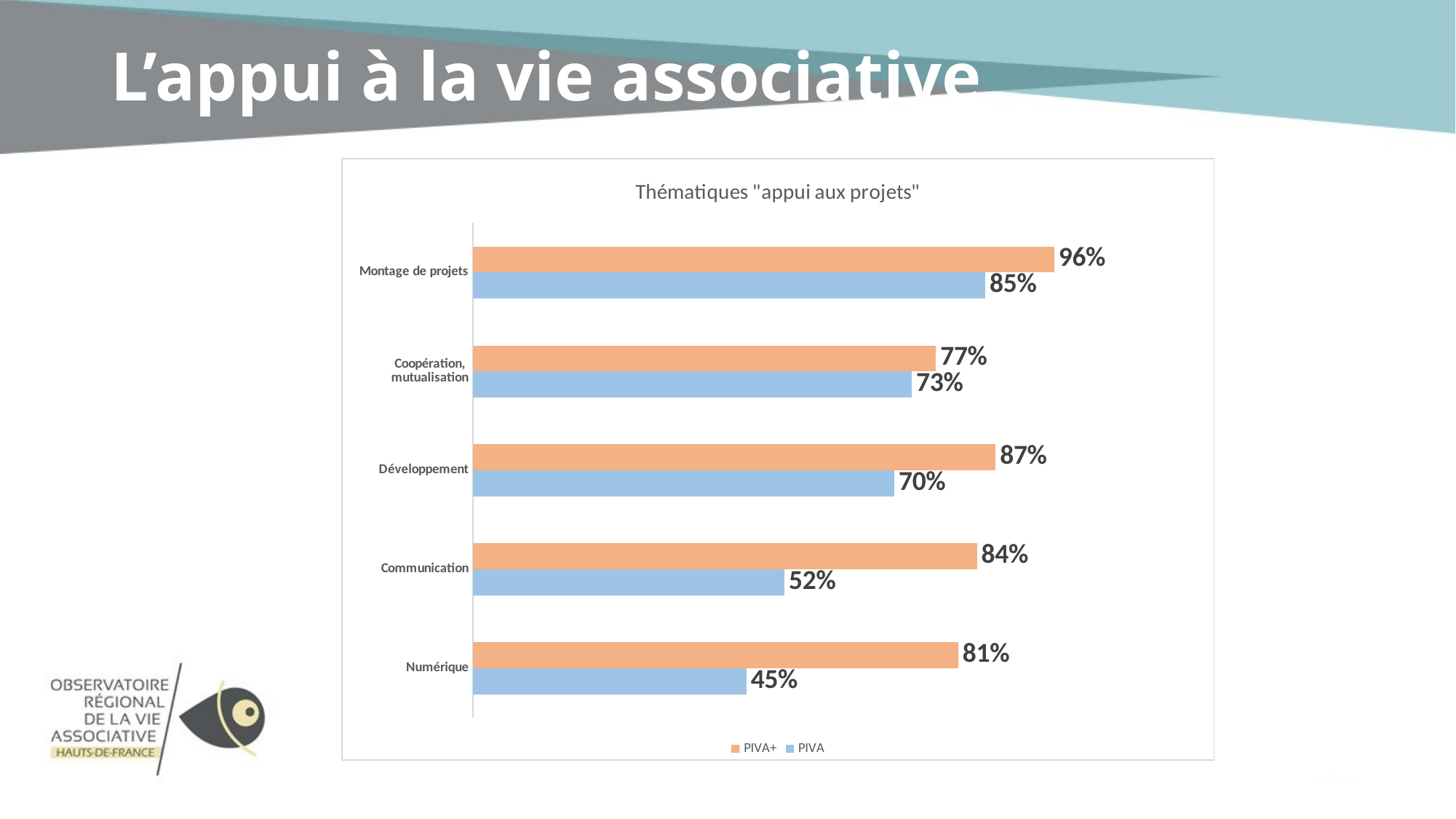
What is the PIVA value for Numérique? 45% What is the title of the chart? Thématiques "appui aux projets" How many categories are shown on the chart? 5 What is the difference between the PIVA+ and PIVA values for Communication? 32% What is the PIVA+ value for Montage de projets? 96% What is the PIVA value for Communication? 52% What is the difference between the PIVA+ and PIVA values for Développement? 17% How many series does the legend list? 2 Which is larger for Coopération, mutualisation: the PIVA+ value or the PIVA value? PIVA+ Which category has the lowest PIVA value? Numérique Which category has the highest PIVA+ value? Montage de projets What kind of chart is shown on the slide? Bar chart